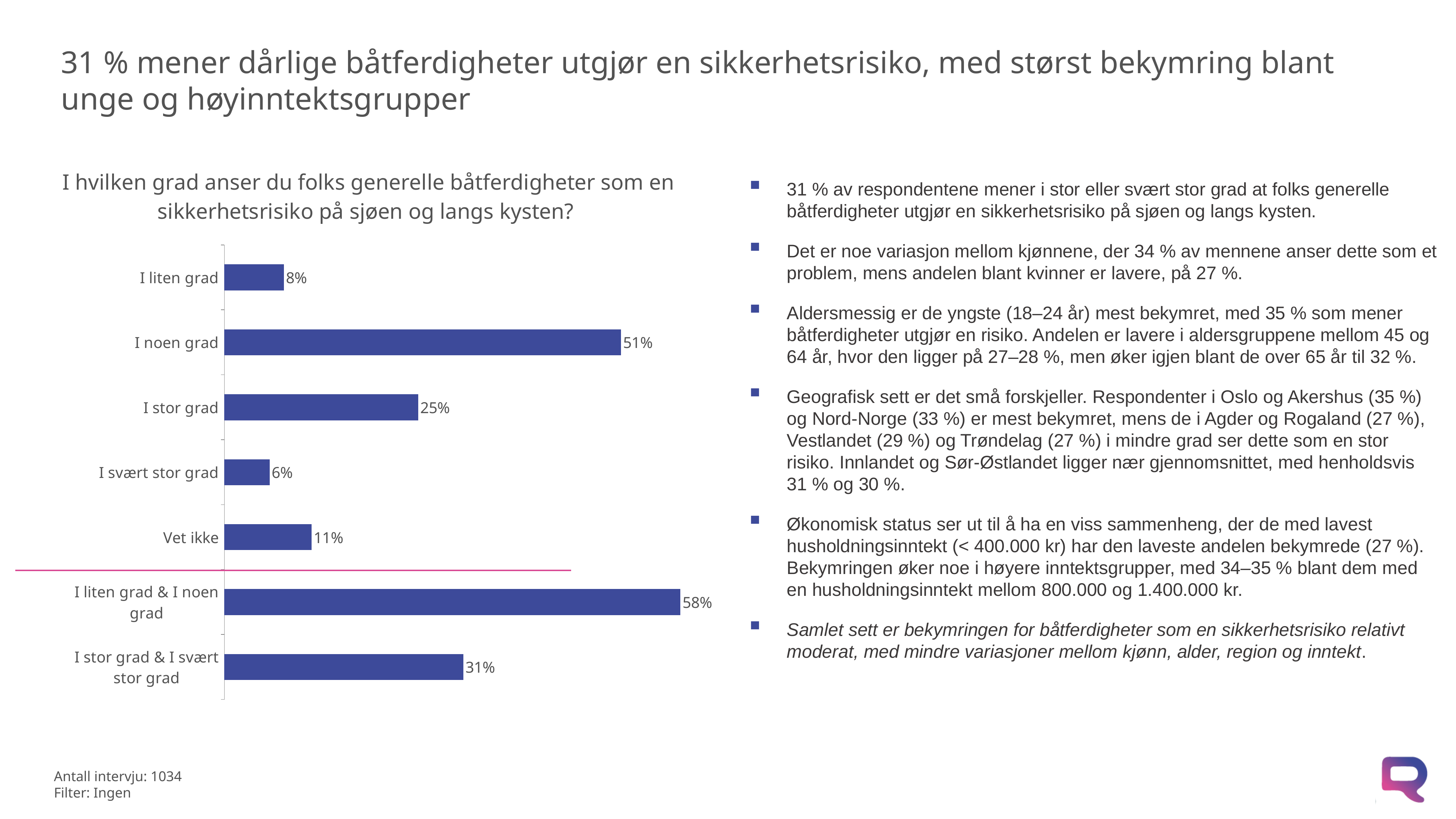
Which category has the lowest value? I svært stor grad What is the difference between the values for "I noen grad" and "I stor grad"? 26% What is the title of the chart? I hvilken grad anser du folks generelle båtferdigheter som en sikkerhetsrisiko på sjøen og langs kysten? What is the difference between the values for "I liten grad & I noen grad" and "I stor grad & I svært stor grad"? 27% Which is larger, the value for "I liten grad" or the value for "Vet ikke"? Vet ikke What is the value for "Vet ikke"? 11% What is the value for "I noen grad"? 51% What is the value for "I stor grad & I svært stor grad"? 31% What is the value for "I svært stor grad"? 6% Which category has the highest value? I liten grad & I noen grad How many categories are shown in the chart? 7 What kind of chart is shown on the slide? Bar chart